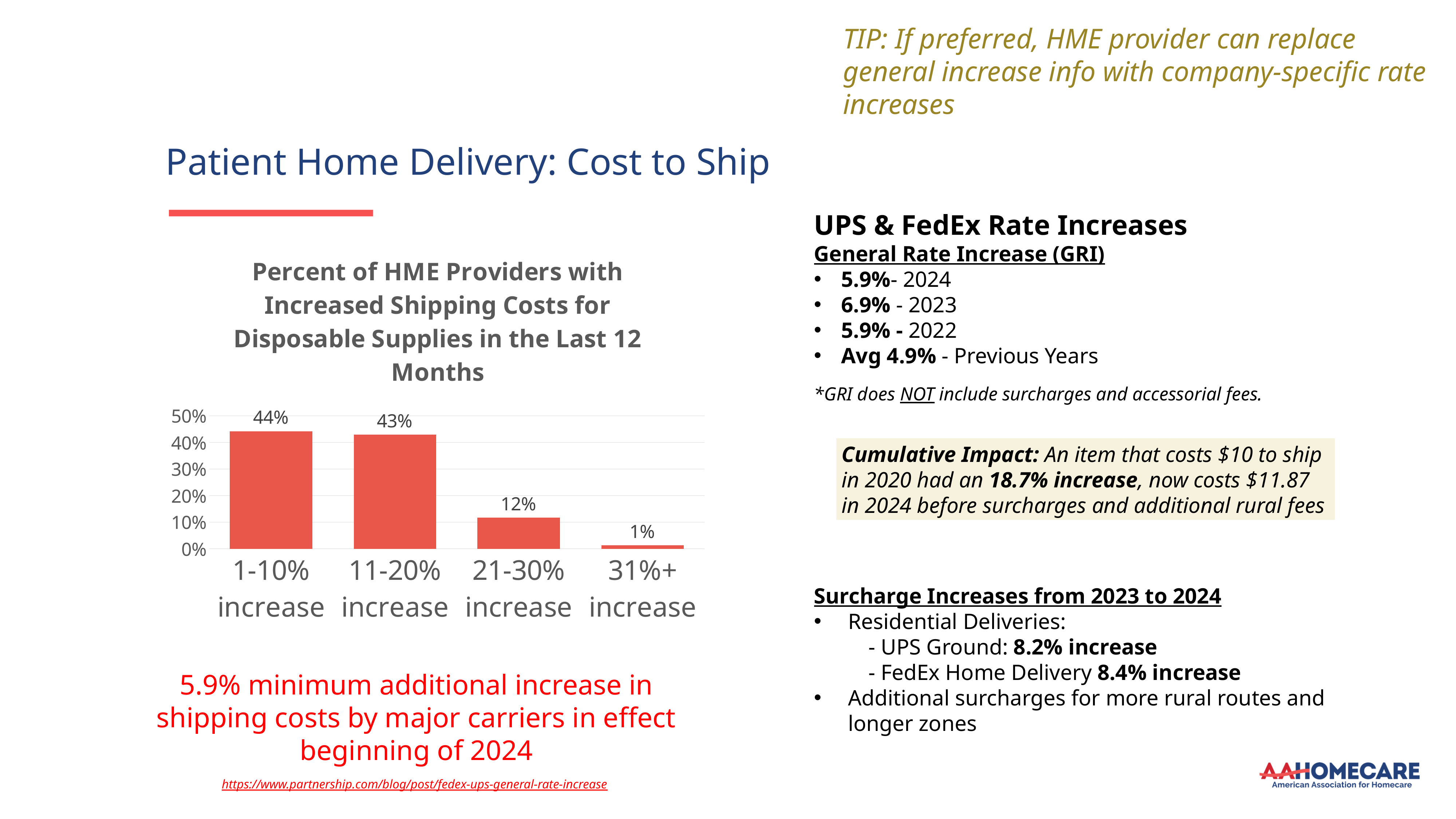
What is the difference between the 1-10% increase category and the 31%+ increase category? 43% Which category has the lowest percent of HME providers? 31%+ increase What is the difference between the 11-20% increase category and the 21-30% increase category? 31% What percent of HME providers reported a 31%+ increase in shipping costs? 1% What percent of HME providers reported a 1-10% increase in shipping costs? 44% Is the value for 21-30% increase greater or less than 20%? less Do the values rise or fall moving from left to right along the x axis? fall What kind of chart is shown on the slide? bar chart What percent of HME providers reported a 21-30% increase in shipping costs? 12% How many categories are shown on the x axis of the chart? 4 Which is larger: the value for 11-20% increase or the value for 21-30% increase? 11-20% increase What percent of HME providers reported an 11-20% increase in shipping costs? 43%